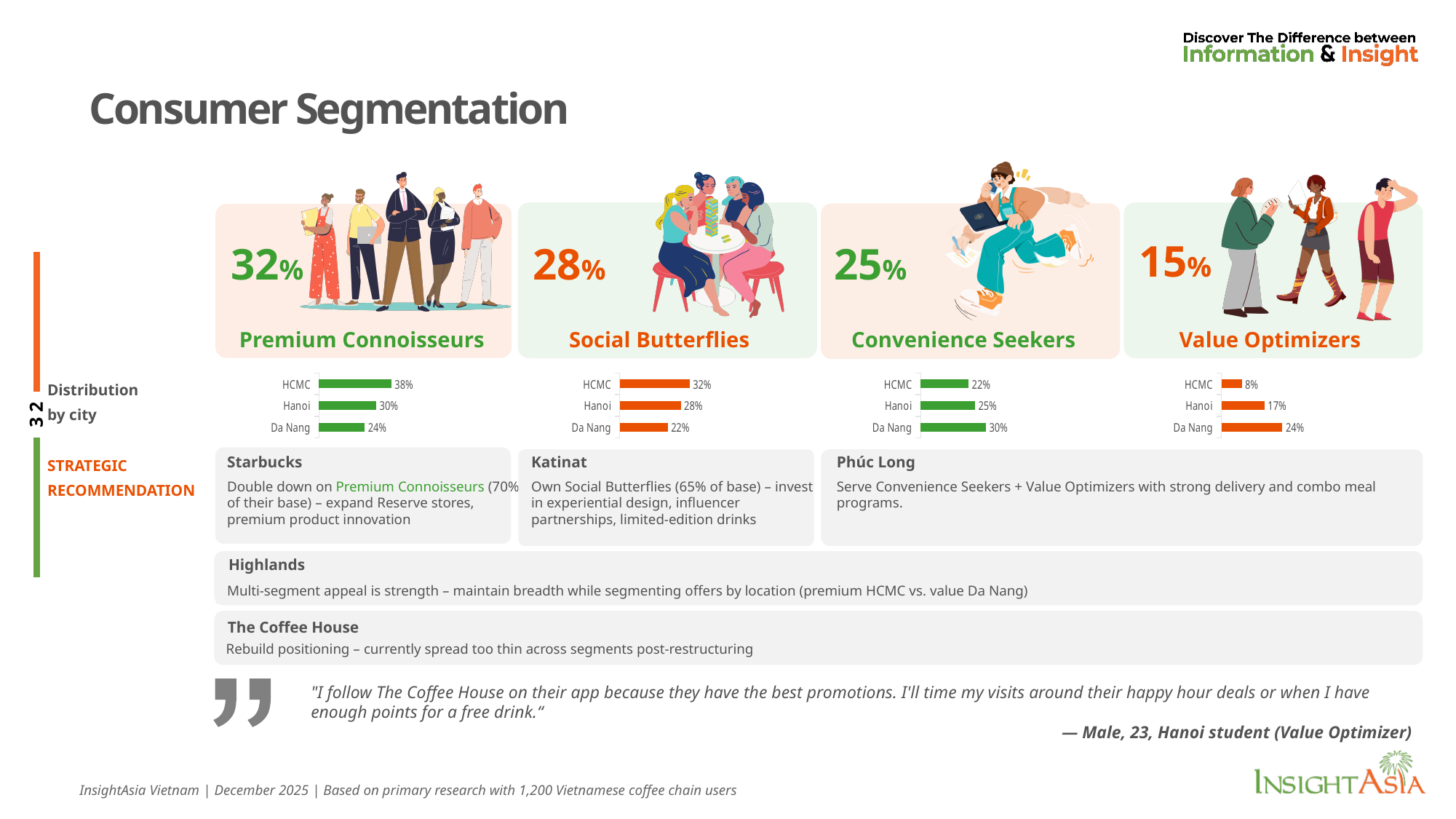
In the Value Optimizers distribution by city chart, which city has the lowest value? HCMC In the Convenience Seekers distribution by city chart, which is larger, the value for HCMC or the value for Hanoi? Hanoi What colour are the bars in the Social Butterflies distribution by city chart? Orange In the Value Optimizers distribution by city chart, do the values rise or fall going from HCMC to Hanoi to Da Nang? Rise In the Premium Connoisseurs distribution by city chart, do the values rise or fall going from HCMC to Hanoi to Da Nang? Fall What kind of chart is used to show the distribution by city for each segment? Bar chart In the Premium Connoisseurs distribution by city chart, what is the difference between the HCMC and Da Nang values? 14% How many cities are shown in the Social Butterflies distribution by city chart? 3 In the Premium Connoisseurs distribution by city chart, what is the value for HCMC? 38% In the Value Optimizers distribution by city chart, what is the value for Hanoi? 17% In the Convenience Seekers distribution by city chart, which city has the highest value? Da Nang In the Social Butterflies distribution by city chart, what is the value for Da Nang? 22%